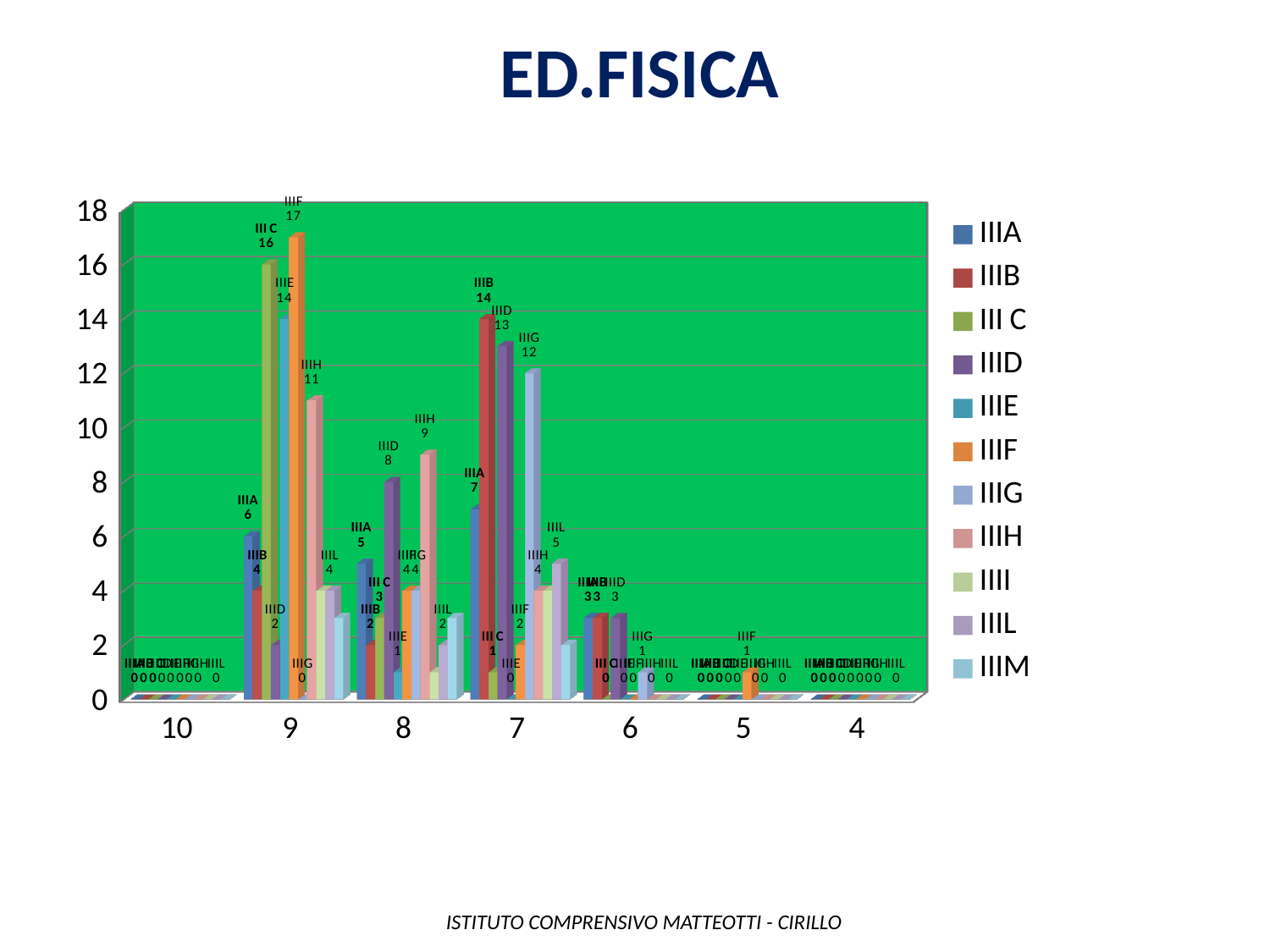
What is the value for IIIH in category 9? 11 Which series has the highest value in category 9? IIIF What is the value for IIIF in category 9? 17 What is the value for III C in category 9? 16 How many series does the legend list? 11 What is the title of the chart? ED.FISICA What is the difference between the IIIF value and the III C value in category 9? 1 What type of chart is shown on the slide? bar chart In category 8, which is larger: the value for IIIH or the value for IIID? IIIH What is the value for IIID in category 7? 13 How many categories are shown on the x axis? 7 What is the value for IIIB in category 7? 14